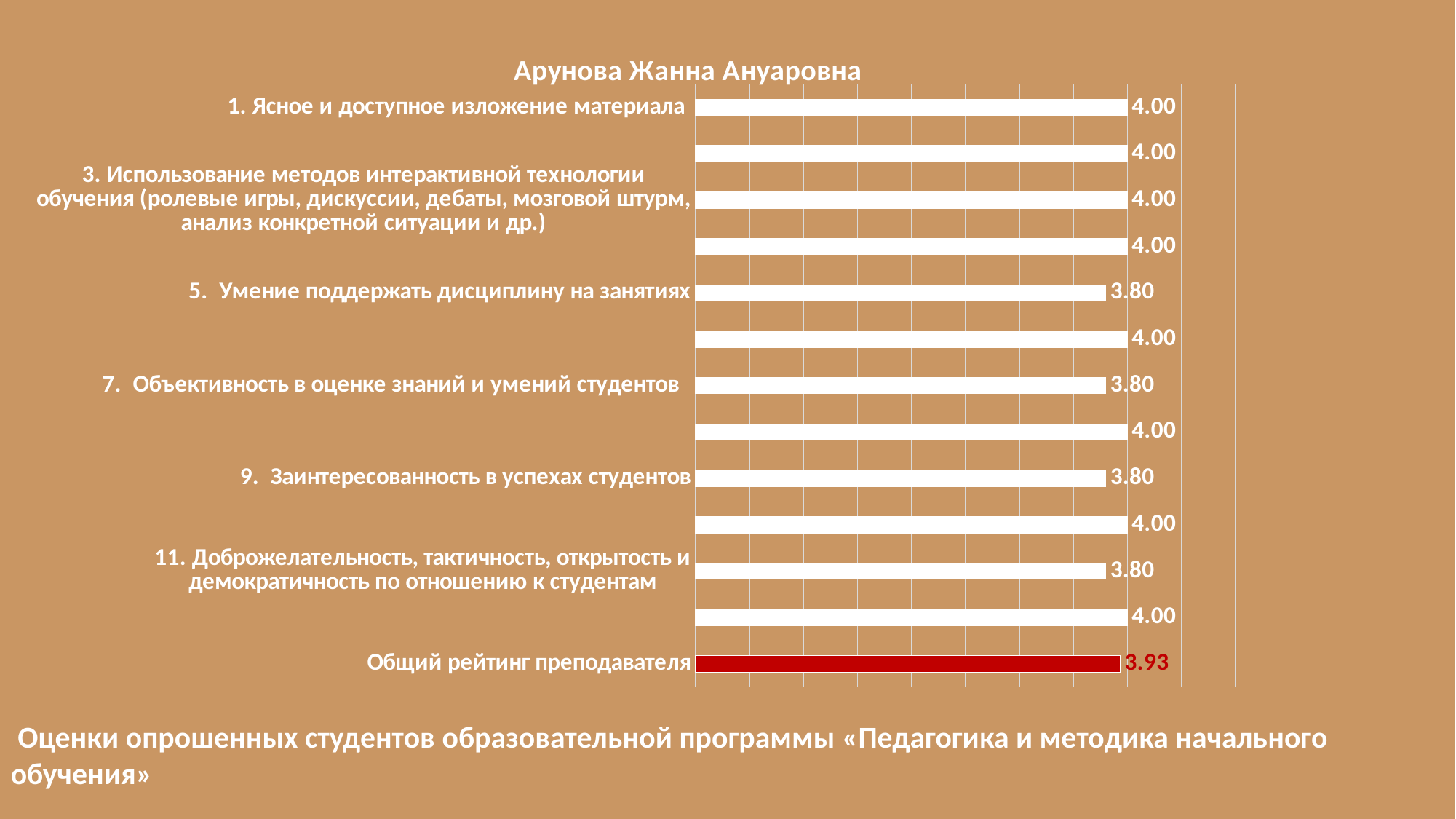
What is the value for "Общий рейтинг преподавателя"? 3.93 What kind of chart is shown on the slide? Bar chart Which is larger: the value for "1. Ясное и доступное изложение материала" or the value for "11. Доброжелательность, тактичность, открытость и демократичность по отношению к студентам"? 1. Ясное и доступное изложение материала What is the title of the chart? Арунова Жанна Ануаровна What is the difference between the value for "1. Ясное и доступное изложение материала" and the value for "5. Умение поддержать дисциплину на занятиях"? 0.20 What is the value for "7. Объективность в оценке знаний и умений студентов"? 3.80 What is the value for "9. Заинтересованность в успехах студентов"? 3.80 How many bars are plotted in the chart? 13 Which is larger: the value for "Общий рейтинг преподавателя" or the value for "9. Заинтересованность в успехах студентов"? Общий рейтинг преподавателя What is the value for "5. Умение поддержать дисциплину на занятиях"? 3.80 What is the value for "3. Использование методов интерактивной технологии обучения"? 4.00 What is the value for "1. Ясное и доступное изложение материала"? 4.00